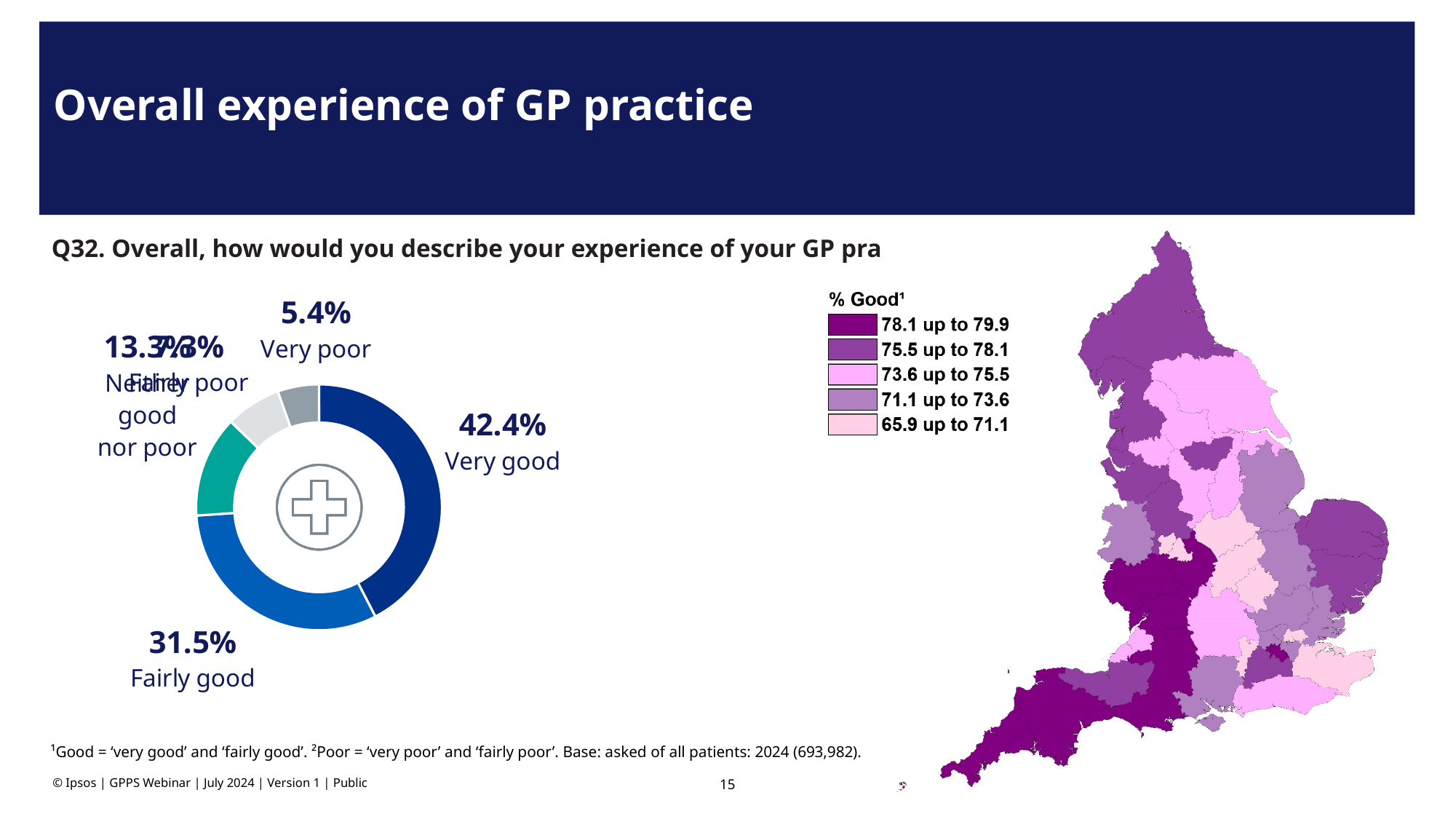
What percentage of patients described their experience as 'Very poor'? 5.4% What percentage of patients described their experience of their GP practice as 'Very good'? 42.4% Which response category has the smallest share of the donut chart? Very poor What percentage of patients described their experience as 'Fairly good'? 31.5% What range does the darkest colour band in the map legend represent? 78.1 up to 79.9 What is the difference in percentage points between 'Very good' and 'Fairly good'? 10.9 Which response category has the largest share of the donut chart? Very good How many colour bands does the '% Good' map legend list? 5 Which is larger, the share for 'Fairly good' or the share for 'Very poor'? Fairly good What is the combined percentage for 'Very good' and 'Fairly good'? 73.9% What kind of chart is used to show the responses to Q32? Donut (pie) chart How many response categories are shown in the donut chart? 5